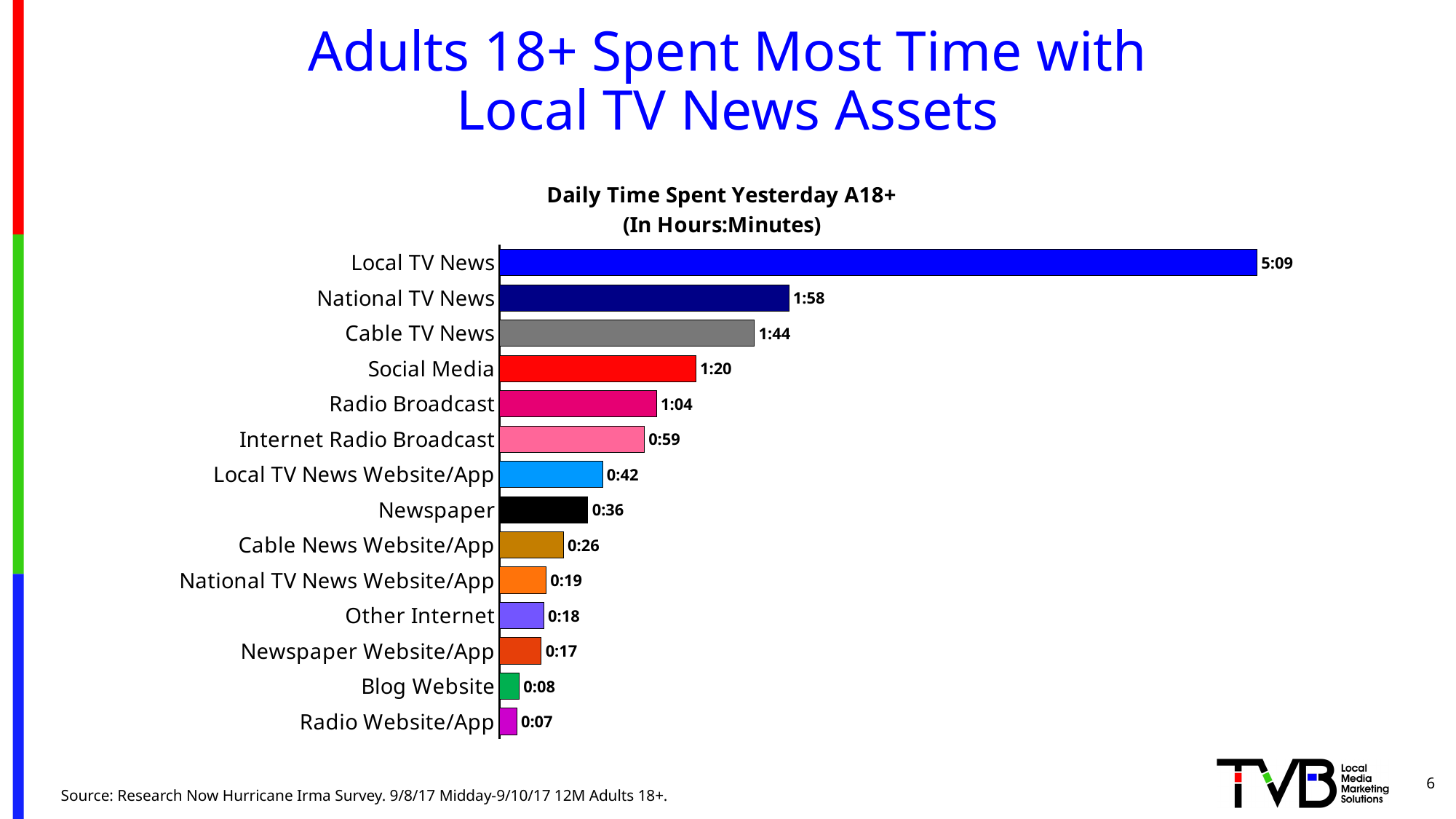
How many categories are shown in the chart? 14 Which has a higher daily time spent, Radio Broadcast or Local TV News Website/App? Radio Broadcast What kind of chart is shown on the slide? Bar chart What is the daily time spent for Social Media? 1:20 Which category has the lowest daily time spent? Radio Website/App Which category has the highest daily time spent? Local TV News What is the difference in time spent between Cable TV News and Cable News Website/App? 1:18 What is the daily time spent for Newspaper? 0:36 What is the daily time spent for Internet Radio Broadcast? 0:59 What is the daily time spent for Local TV News? 5:09 What is the title of the chart? Daily Time Spent Yesterday A18+ (In Hours:Minutes) How much more time was spent with Local TV News than with National TV News? 3:11